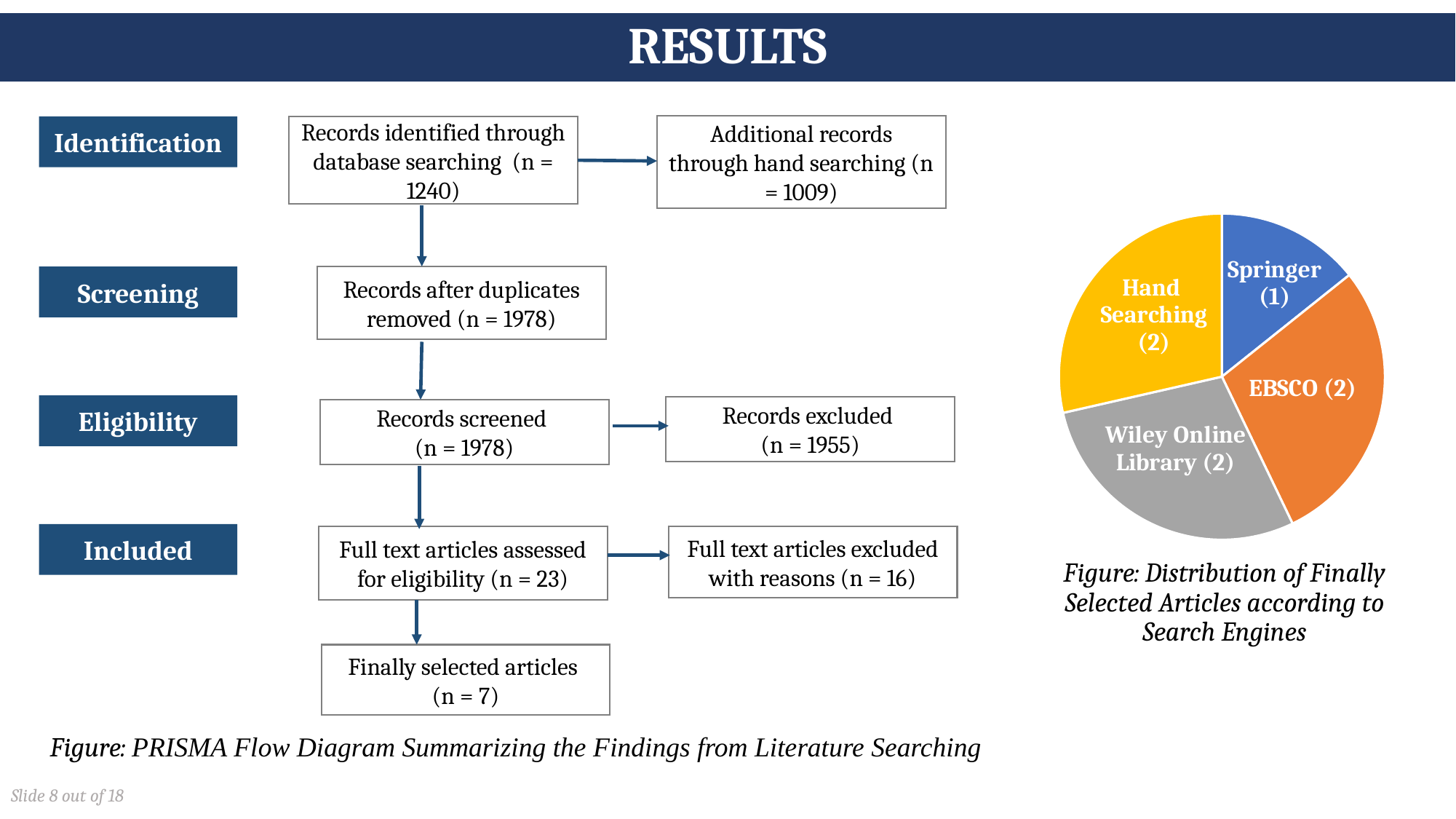
What share of the articles in the pie chart came from Springer? 1 of 7 In the pie chart, how many articles came from Hand Searching? 2 Which source in the pie chart contributed the fewest finally selected articles? Springer What kind of chart is shown on the right side of the slide? Pie chart What is the total number of articles represented in the pie chart? 7 In the pie chart, what is the difference between the number of articles from EBSCO and from Springer? 1 How many slices does the pie chart have? 4 In the pie chart, how many articles came from Wiley Online Library? 2 In the pie chart, how many articles came from EBSCO? 2 What colour is the EBSCO slice in the pie chart? Orange In the pie chart, which contributed more articles, EBSCO or Springer? EBSCO In the pie chart, how many articles came from Springer? 1